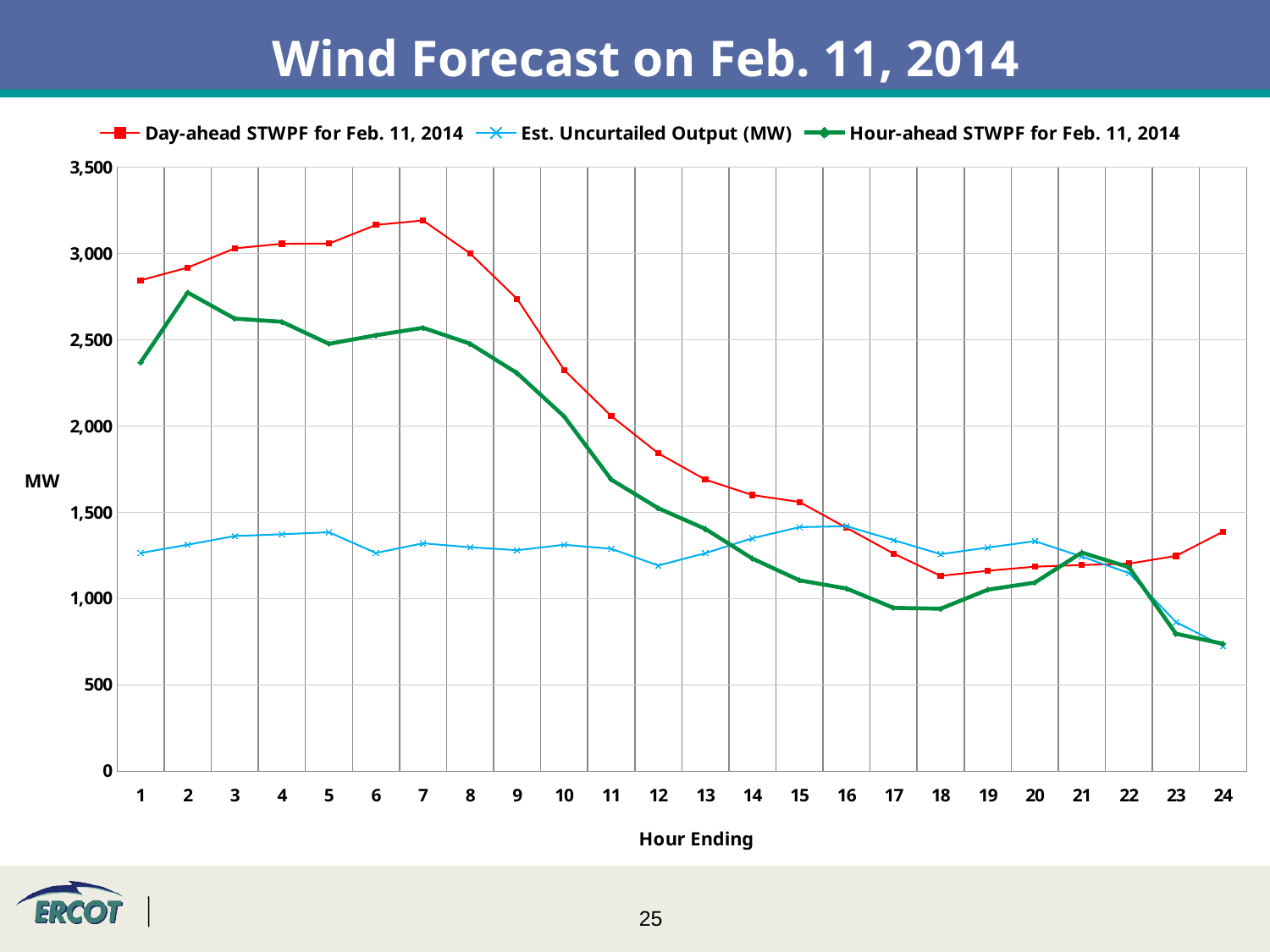
What is the title of the x axis? Hour Ending Which hour has the highest value for the Hour-ahead STWPF for Feb. 11, 2014 series? 2 Is the Est. Uncurtailed Output value at hour ending 12 greater or less than 1,500? less What kind of chart is shown on the slide? line chart Is the Hour-ahead STWPF value at hour ending 1 greater or less than 2,500? less Which hour has the lowest value for the Hour-ahead STWPF for Feb. 11, 2014 series? 24 At hour ending 15, which is larger: Est. Uncurtailed Output or Hour-ahead STWPF? Est. Uncurtailed Output Does the Day-ahead STWPF series rise or fall between hour ending 7 and hour ending 18? fall How many series does the legend list? 3 Is the Day-ahead STWPF value at hour ending 7 greater or less than 3,000? greater How many hours are plotted along the x axis? 24